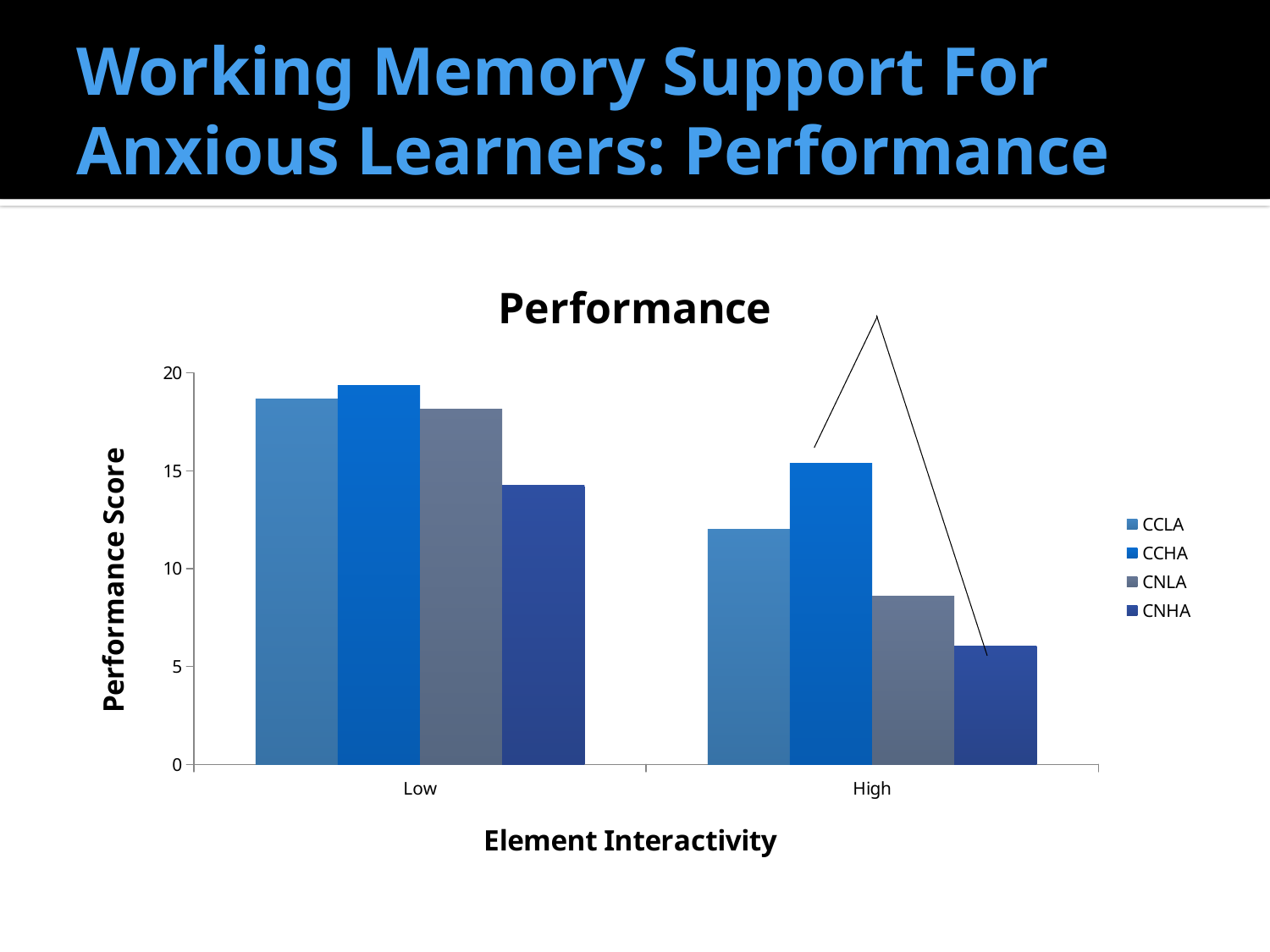
Which series has the lowest value in the High element interactivity category? CNHA Is the value for CNLA at High element interactivity greater or less than 10? less What kind of chart is shown on the slide? bar chart Which series has the highest value in the High element interactivity category? CCHA Do the values for CNHA rise or fall from Low to High element interactivity? fall What is the label of the y axis? Performance Score Which series has the lowest value in the Low element interactivity category? CNHA How many categories are shown on the x axis? 2 Is the value for CCHA at Low element interactivity greater or less than 15? greater Is the value for CNHA at High element interactivity greater or less than 10? less How many series does the legend list? 4 Which is larger, the CCLA value at High or the CNLA value at High? CCLA at High